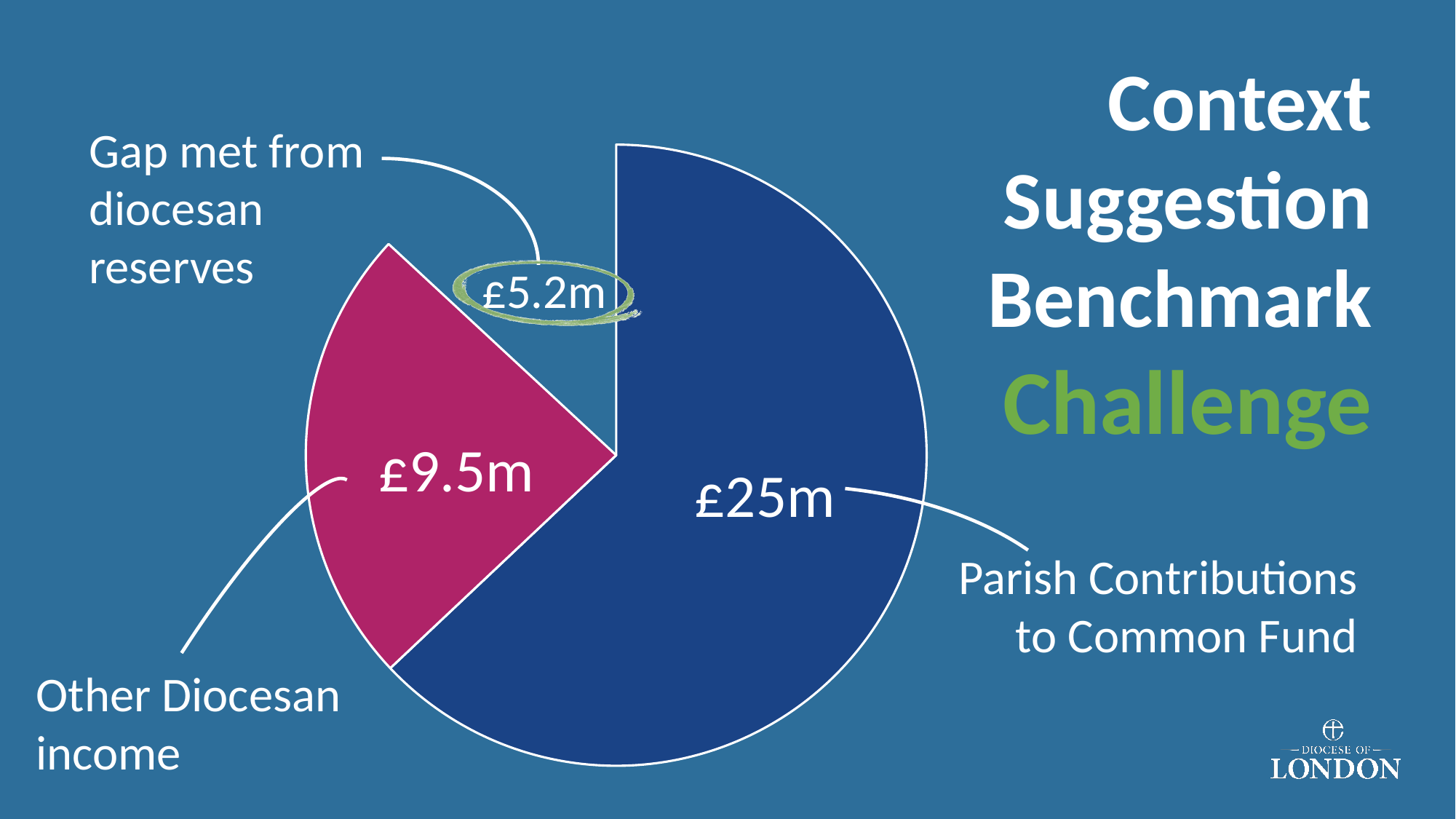
What is the difference between Parish Contributions to Common Fund and Other Diocesan income? £15.5m Which word in the slide's title text is shown in green? Challenge What is the difference between Other Diocesan income and the gap met from diocesan reserves? £4.3m What is the value of the Other Diocesan income slice? £9.5m What value is shown for the gap met from diocesan reserves? £5.2m What kind of chart is shown on the slide? pie chart What is the value of the Parish Contributions to Common Fund slice? £25m Which is larger, Other Diocesan income or the gap met from diocesan reserves? Other Diocesan income How many segments does the pie chart have? 3 What is the total of the three values shown in the pie chart? £39.7m Which segment of the pie chart is the smallest? Gap met from diocesan reserves Which segment of the pie chart is the largest? Parish Contributions to Common Fund